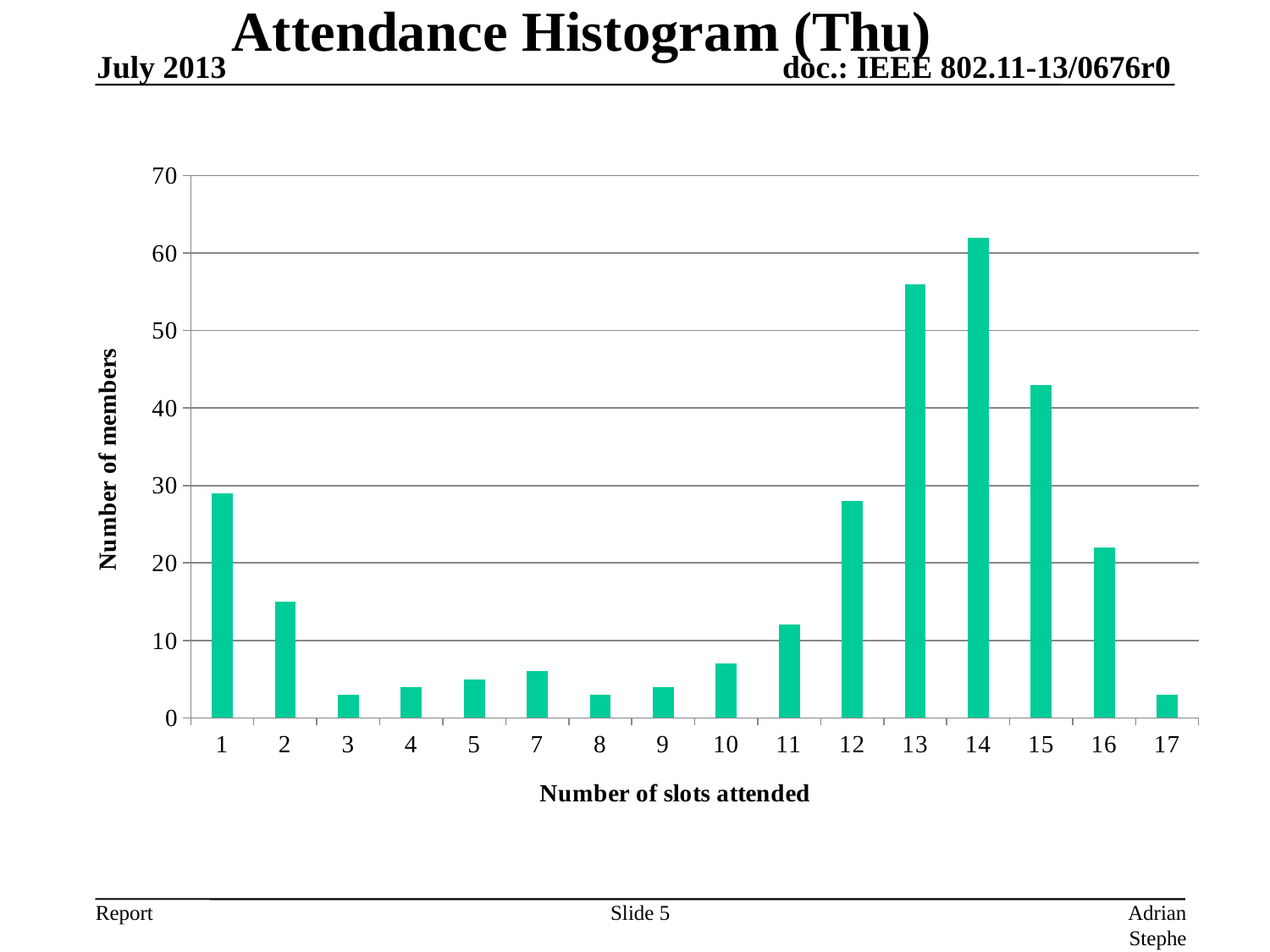
Is the number of members for 14 slots attended greater or less than 60? greater Which has more members: 1 slot attended or 2 slots attended? 1 Is the number of members for 13 slots attended greater or less than 50? greater Which number of slots attended has the highest number of members? 14 Which has more members: 13 slots attended or 15 slots attended? 13 Is the number of members for 15 slots attended greater or less than 40? greater What is the label of the y axis? Number of members What kind of chart is shown on the slide? bar chart How many categories are shown on the x axis? 16 Do the values rise or fall from 7 slots attended to 14 slots attended? rise